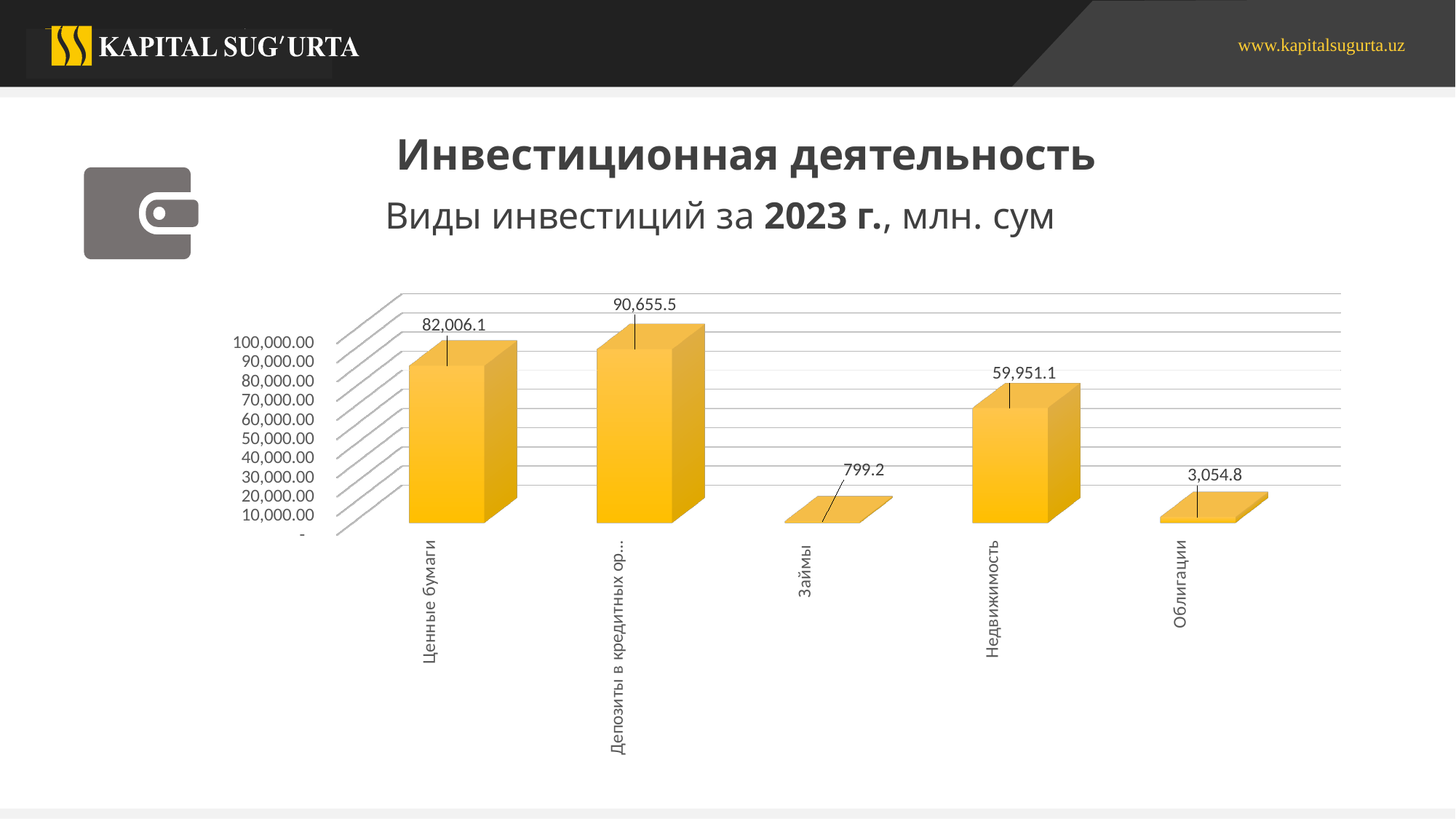
What kind of chart is shown on the slide? Bar chart What is the value for Займы? 799.2 What is the value for Ценные бумаги? 82,006.1 What is the value for the category labelled 'Депозиты в кредитных ор...'? 90,655.5 What is the value for Недвижимость? 59,951.1 How many categories are shown in the chart? 5 Which category has the lowest value? Займы Is the value for Недвижимость greater or less than 50,000.00? greater Which category has the highest value? Депозиты в кредитных ор... Which is larger, the value for Облигации or the value for Займы? Облигации What is the difference between the values for Ценные бумаги and Недвижимость? 22,055.0 What is the value for Облигации? 3,054.8